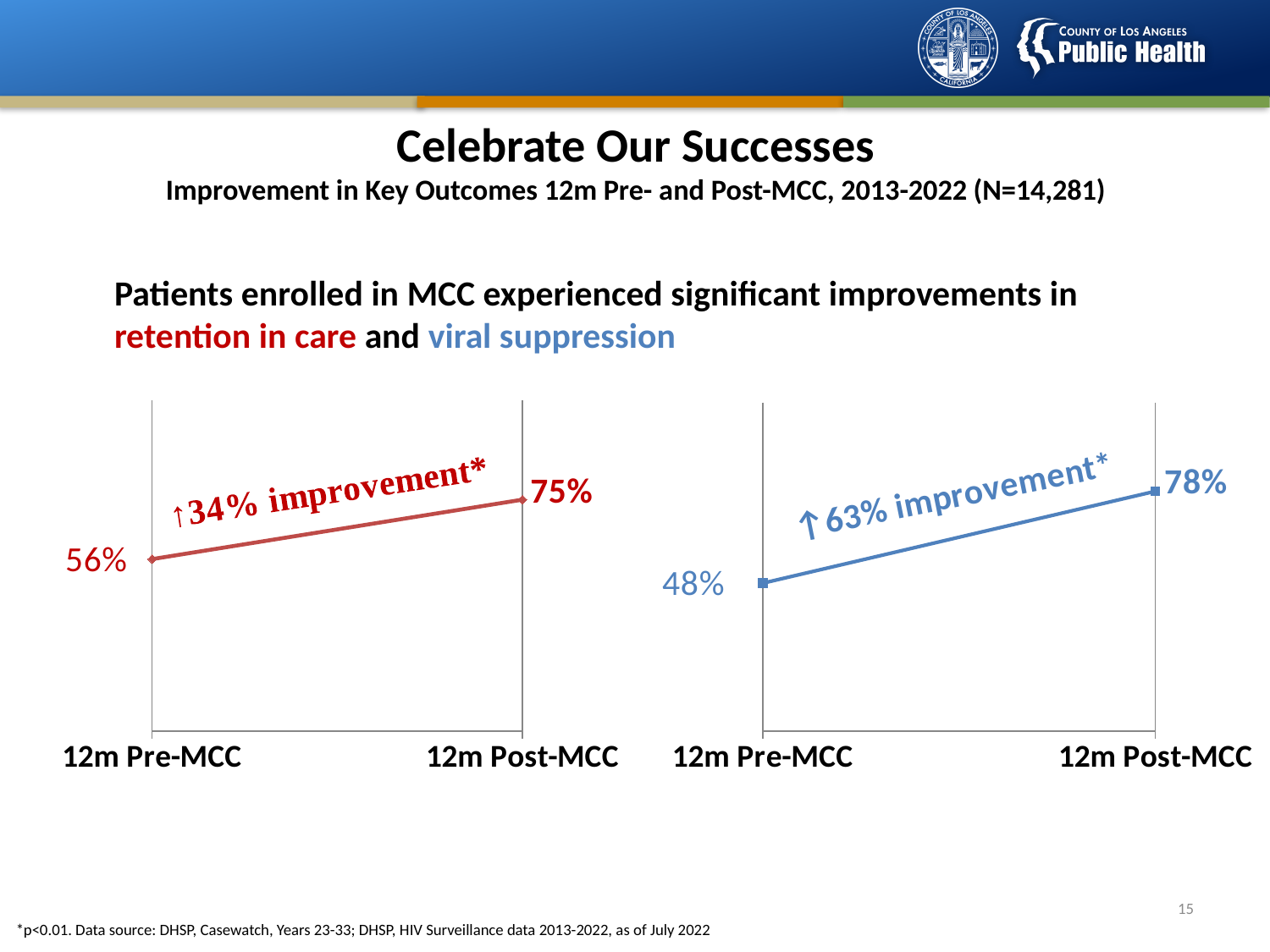
In the left (red) chart, what is the difference between the 12m Post-MCC and 12m Pre-MCC values? 19% In the left (red) chart, what is the value for 12m Post-MCC? 75% In the left (red) chart, do the values rise or fall from 12m Pre-MCC to 12m Post-MCC? rise How many data points are plotted in the right (blue) chart? 2 In the right (blue) chart, what is the value for 12m Post-MCC? 78% In the right (blue) chart, what is the difference between the 12m Post-MCC and 12m Pre-MCC values? 30% In the right (blue) chart, what is the value for 12m Pre-MCC? 48% In the right (blue) chart, do the values rise or fall from 12m Pre-MCC to 12m Post-MCC? rise Which is larger: the 12m Pre-MCC value in the left (red) chart or the 12m Pre-MCC value in the right (blue) chart? left (red) chart, 56% What kind of chart is the left (red) chart? line chart In the left (red) chart, what is the value for 12m Pre-MCC? 56% What improvement percentage is annotated on the right (blue) chart? 63% improvement*